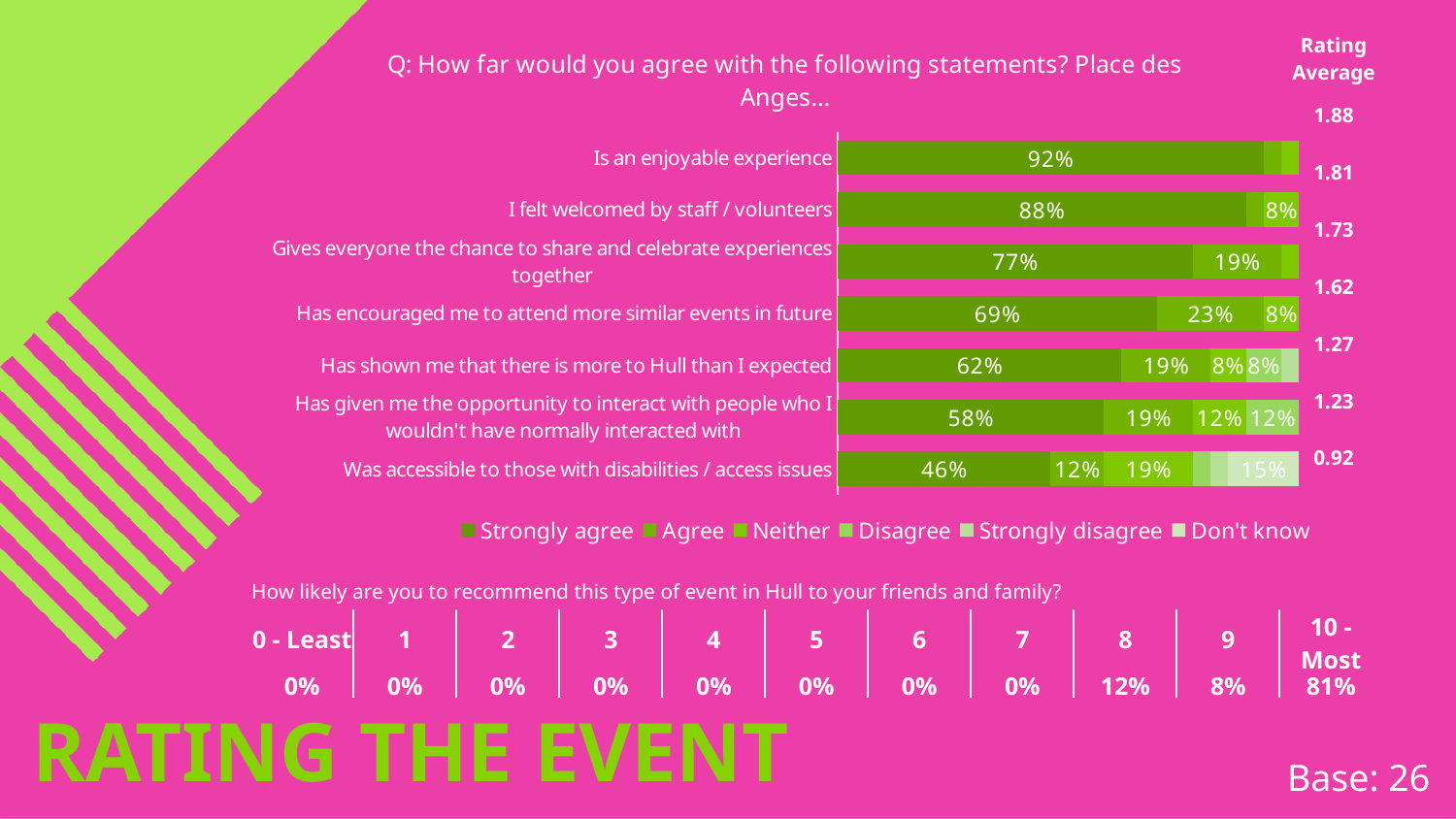
What is the Strongly agree value for 'Is an enjoyable experience'? 92% What is the Agree value for 'Has encouraged me to attend more similar events in future'? 23% How many statements (categories) are plotted in the chart? 7 Which has a larger Strongly agree value: 'Has shown me that there is more to Hull than I expected' or 'Has given me the opportunity to interact with people who I wouldn't have normally interacted with'? Has shown me that there is more to Hull than I expected How many series does the chart legend list? 6 Which series is listed first in the chart legend? Strongly agree Which statement has the lowest Strongly agree value? Was accessible to those with disabilities / access issues Which statement has the highest Strongly agree value? Is an enjoyable experience What is the difference between the Strongly agree values for 'I felt welcomed by staff / volunteers' and 'Gives everyone the chance to share and celebrate experiences together'? 11% What is the Agree value for 'Was accessible to those with disabilities / access issues'? 12% What type of chart is shown on the slide? stacked bar chart What is the Strongly agree value for 'Was accessible to those with disabilities / access issues'? 46%